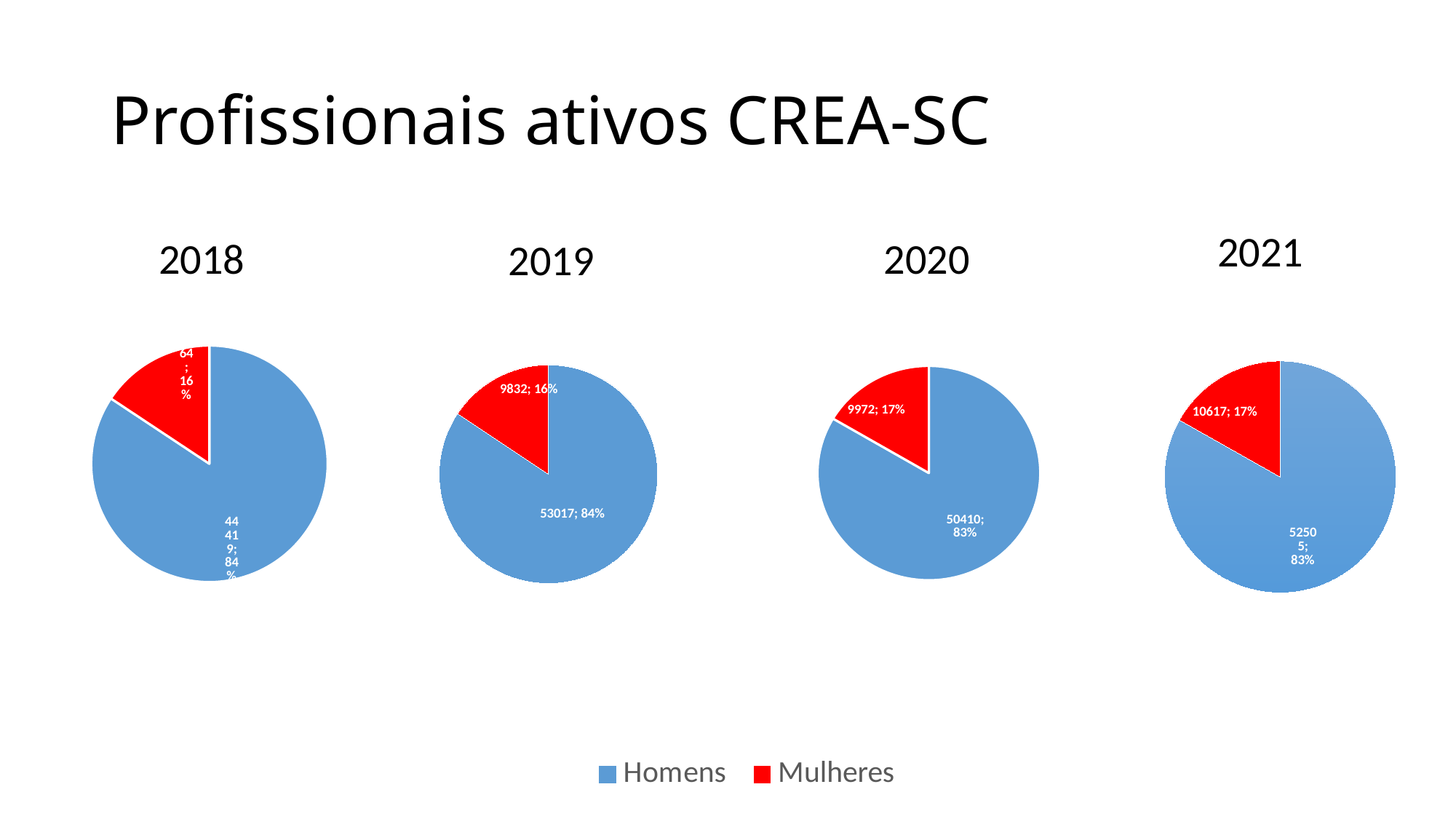
How many series does the legend list? 2 In the 2019 pie chart, what is the difference between the Homens and Mulheres values? 43185 In the 2021 pie chart, what is the value for Homens? 52505 What kind of charts are shown on the slide? Pie charts In the 2019 pie chart, what is the value for Homens? 53017 In the 2020 pie chart, what is the value for Mulheres? 9972 In the 2019 pie chart, what is the value for Mulheres? 9832 In the 2020 pie chart, which is larger, Homens or Mulheres? Homens Which colour represents Mulheres in the legend? Red How many pie charts are on the slide? 4 In the 2018 pie chart, what share of the pie is Homens? 84% In the 2021 pie chart, what share of the pie is Mulheres? 17%